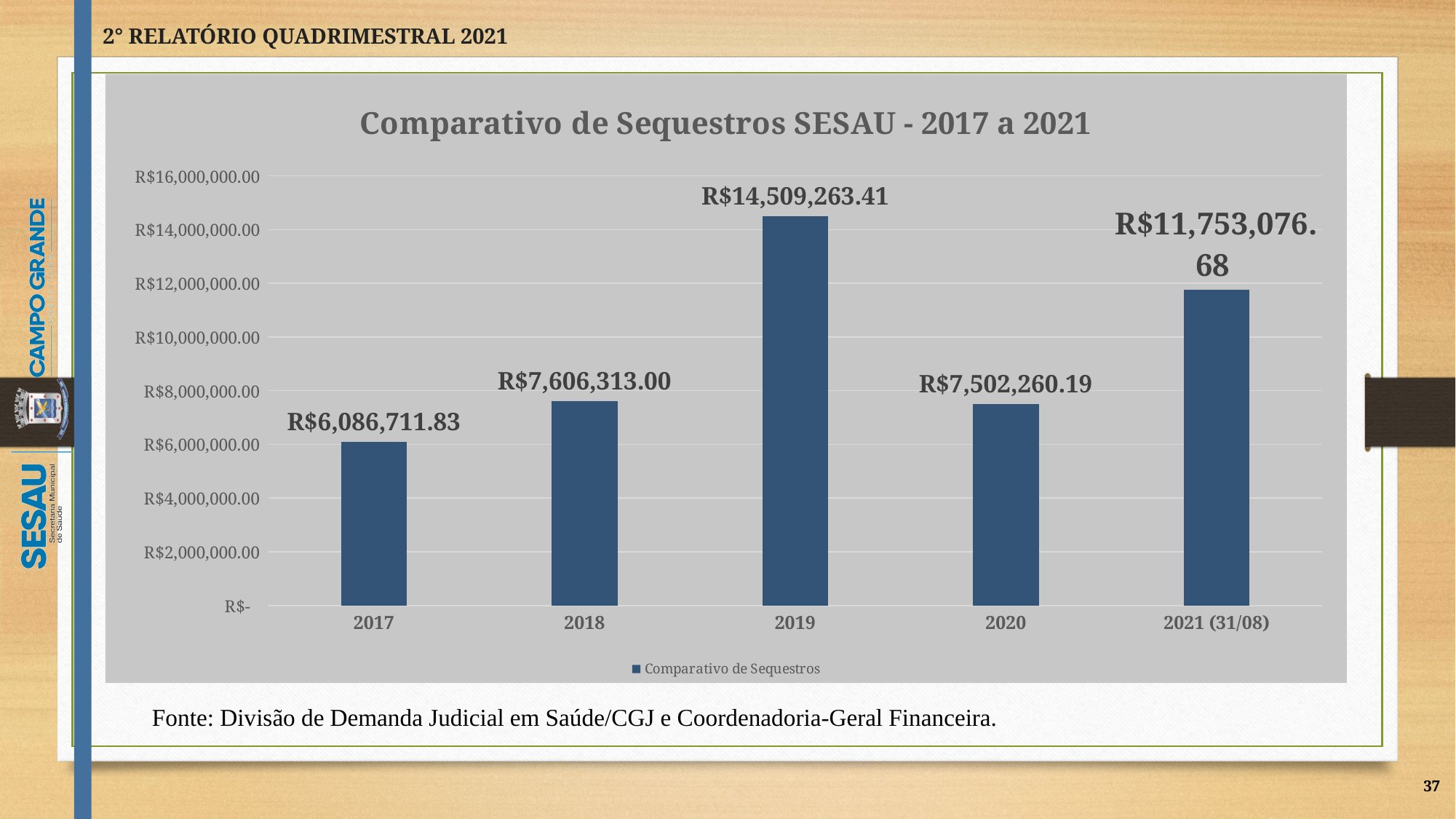
Which year has the highest value in the chart? 2019 How many years are shown on the x axis of the chart? 5 What is the title of the chart? Comparativo de Sequestros SESAU - 2017 a 2021 Which year has the lowest value in the chart? 2017 Is the value for 2021 (31/08) greater or less than R$12,000,000.00? less What kind of chart is shown on the slide? bar chart What is the value for 2021 (31/08) in the chart? R$11,753,076.68 What is the difference between the values for 2019 and 2017? R$8,422,551.58 What is the value for 2019 in the chart? R$14,509,263.41 Which is larger, the value for 2018 or the value for 2020? 2018 What is the value for 2017 in the chart? R$6,086,711.83 What is the difference between the values for 2021 (31/08) and 2020? R$4,250,816.49